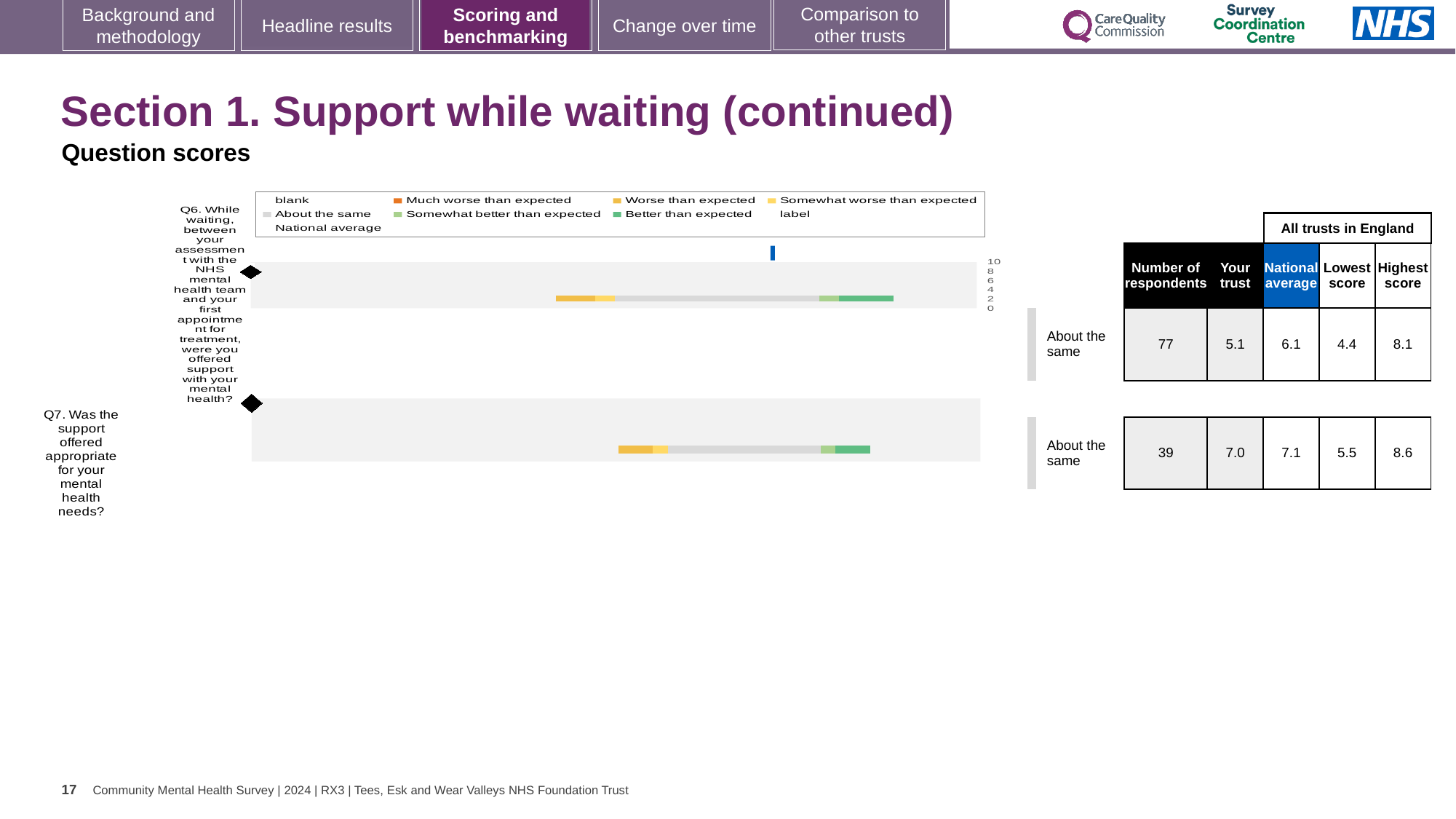
What is the difference between the national average and the 'Your trust' score for Q6? 1.0 How many questions (bars) are plotted in the chart? 2 What is the 'Your trust' score for Q7? 7.0 Which question has the larger 'Your trust' score, Q6 or Q7? Q7 What is the lowest score among all trusts in England for Q6? 4.4 What is the difference between the highest and lowest scores for Q7? 3.1 How many entries does the chart legend list? 9 What is the number of respondents for Q6? 77 What benchmark category is shown for Q7? About the same What is the highest score among all trusts in England for Q7? 8.6 What kind of chart is shown on the slide? bar chart What is the national average score for Q6? 6.1